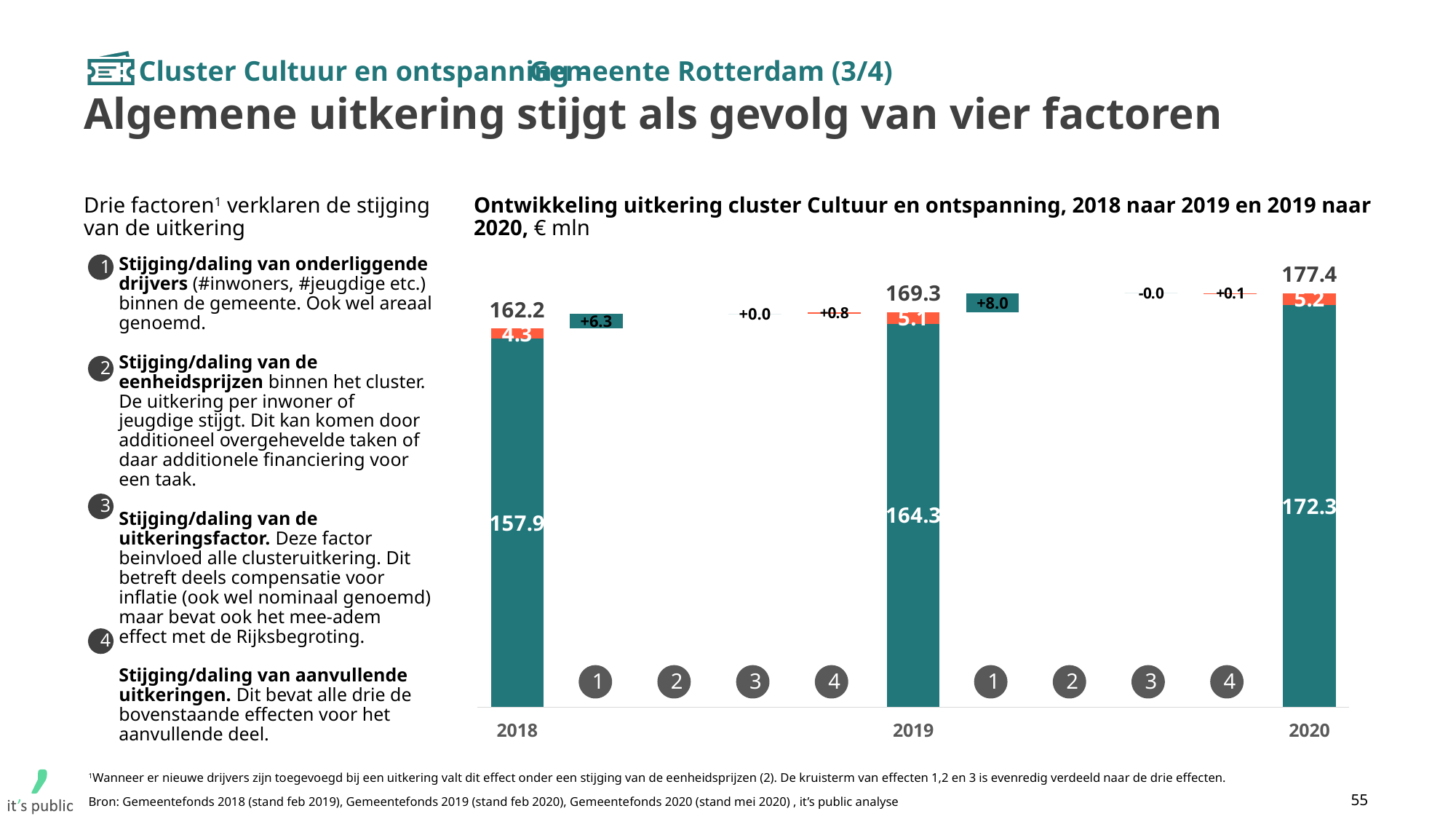
In what unit are the values in the chart expressed? € mln Is the factor 1 effect larger from 2018 to 2019 or from 2019 to 2020? 2019 to 2020 What is the difference between the 2020 total (177.4) and the 2018 total (162.2)? 15.2 What is the total uitkering value shown for 2020? 177.4 Which year has the highest total uitkering? 2020 What is the value of the large teal segment of the 2019 bar? 164.3 What is the effect of factor 1 on the change from 2018 to 2019? +6.3 What is the total uitkering value shown for 2018? 162.2 Do the total uitkering values rise or fall from 2018 to 2020? rise What is the effect of factor 4 on the change from 2018 to 2019? +0.8 What is the value of the orange top segment of the 2018 bar? 4.3 What is the effect of factor 1 on the change from 2019 to 2020? +8.0